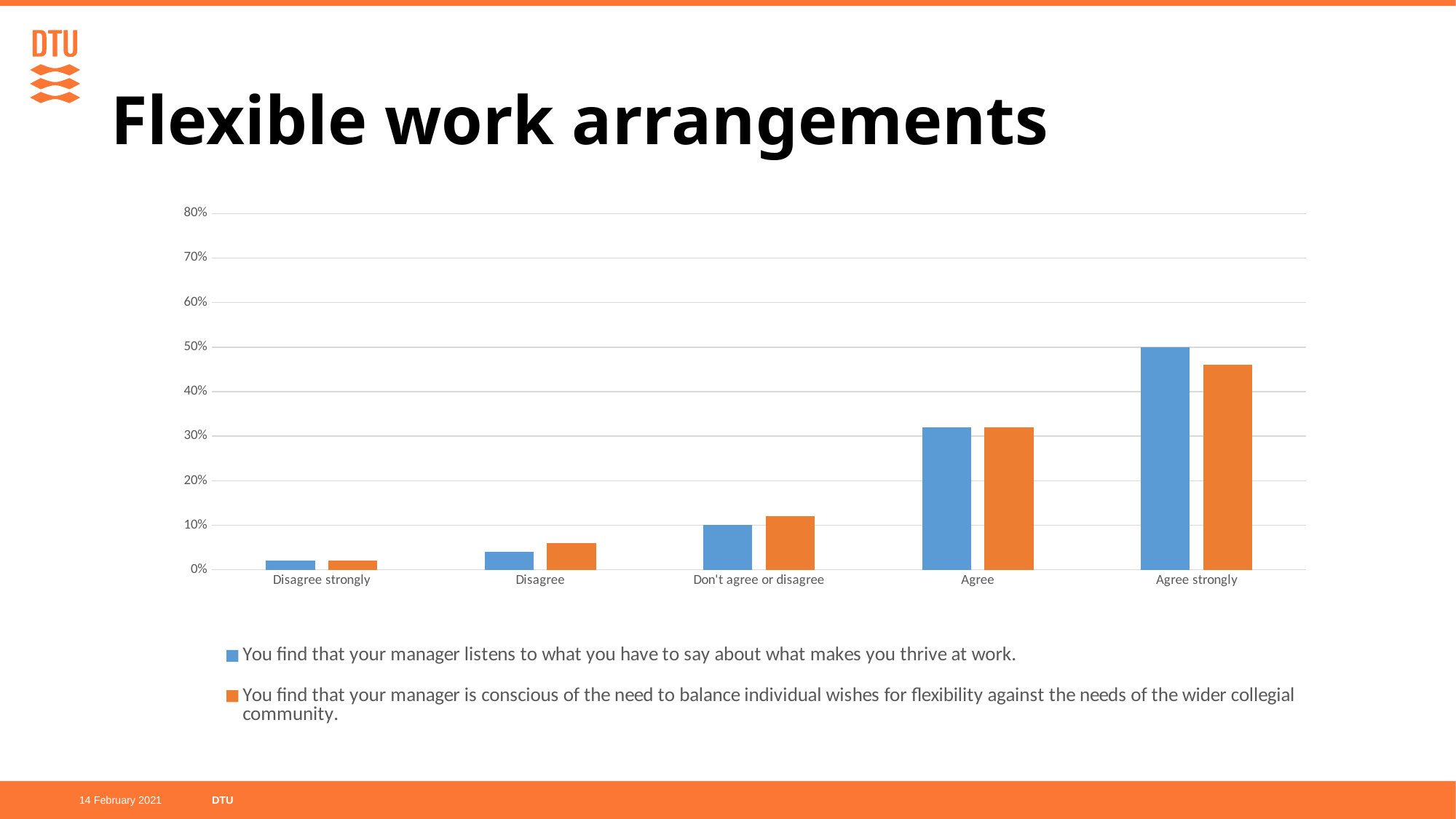
How many series does the legend list? 2 What kind of chart is shown on the slide? bar chart What colour represents the series 'You find that your manager listens to what you have to say about what makes you thrive at work.'? blue Is the value for 'Agree strongly' in the orange series (manager balances flexibility) greater or less than 40%? greater Do the values generally rise or fall moving from 'Disagree strongly' to 'Agree strongly' along the x axis? rise Which category has the lowest value for the series 'You find that your manager is conscious of the need to balance individual wishes for flexibility against the needs of the wider collegial community.'? Disagree strongly How many response categories are shown on the x axis? 5 Is the value for 'Agree' in the blue series (manager listens) greater or less than 30%? greater Is the value for 'Disagree' in the orange series (manager balances flexibility) greater or less than 10%? less Which category has the highest value for the series 'You find that your manager listens to what you have to say about what makes you thrive at work.'? Agree strongly For 'Disagree', which series has the larger value: the blue series (manager listens) or the orange series (manager balances flexibility)? the orange series (manager balances flexibility) For 'Agree strongly', which series has the larger value: the blue series (manager listens) or the orange series (manager balances flexibility)? the blue series (manager listens)